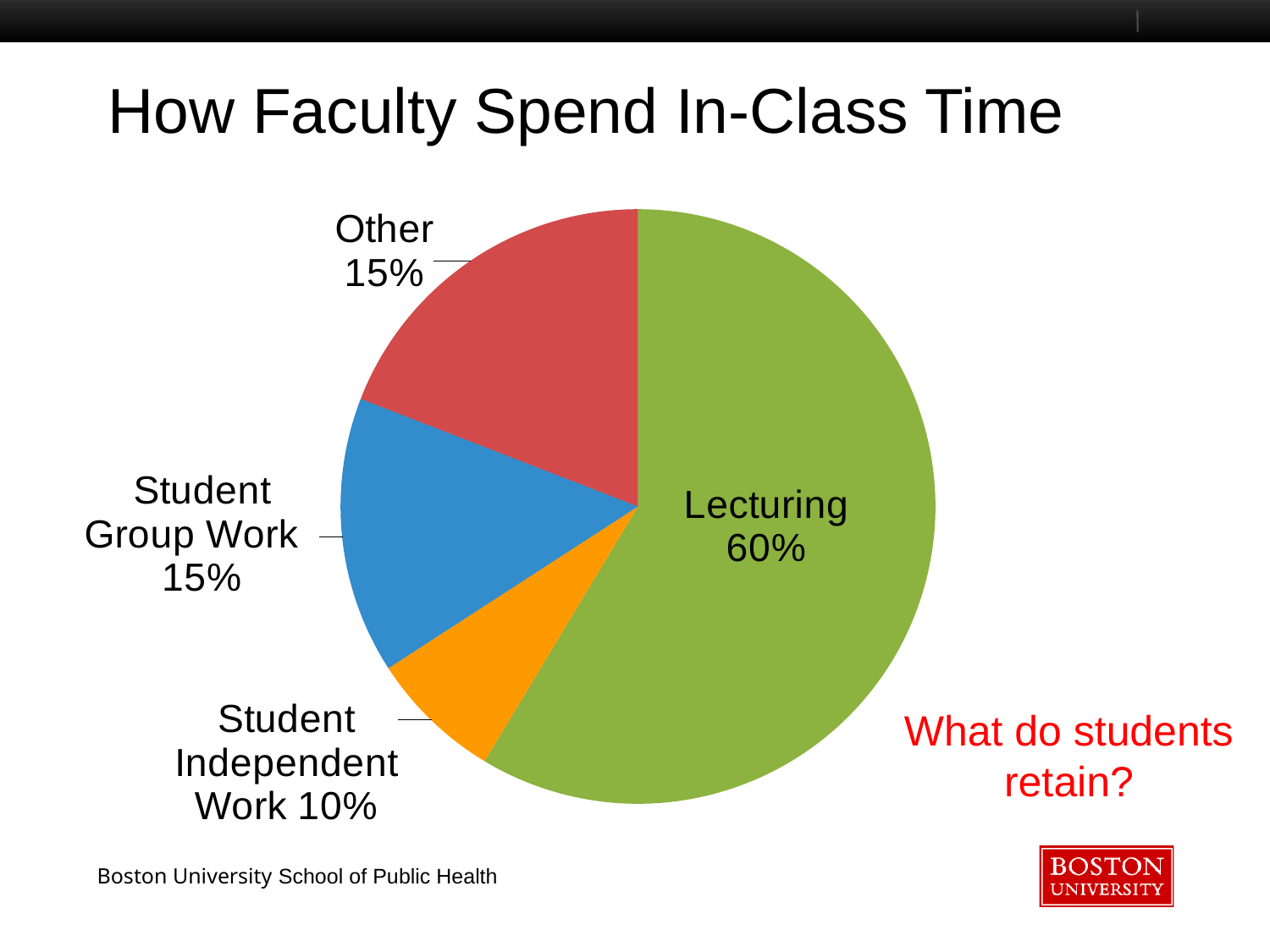
How many categories are shown in the pie chart? 4 What percentage of in-class time is spent on Student Group Work? 15% Which category takes the smallest share of in-class time? Student Independent Work What is the title of the chart? How Faculty Spend In-Class Time Which is larger, the share for Student Group Work or the share for Student Independent Work? Student Group Work What percentage of in-class time is labelled Other? 15% What is the difference in percentage points between Lecturing and Student Group Work? 45 What percentage of in-class time is spent on Lecturing? 60% What colour is the Lecturing slice? Green What kind of chart is shown on the slide? Pie chart Which category takes the largest share of in-class time? Lecturing What percentage of in-class time is spent on Student Independent Work? 10%